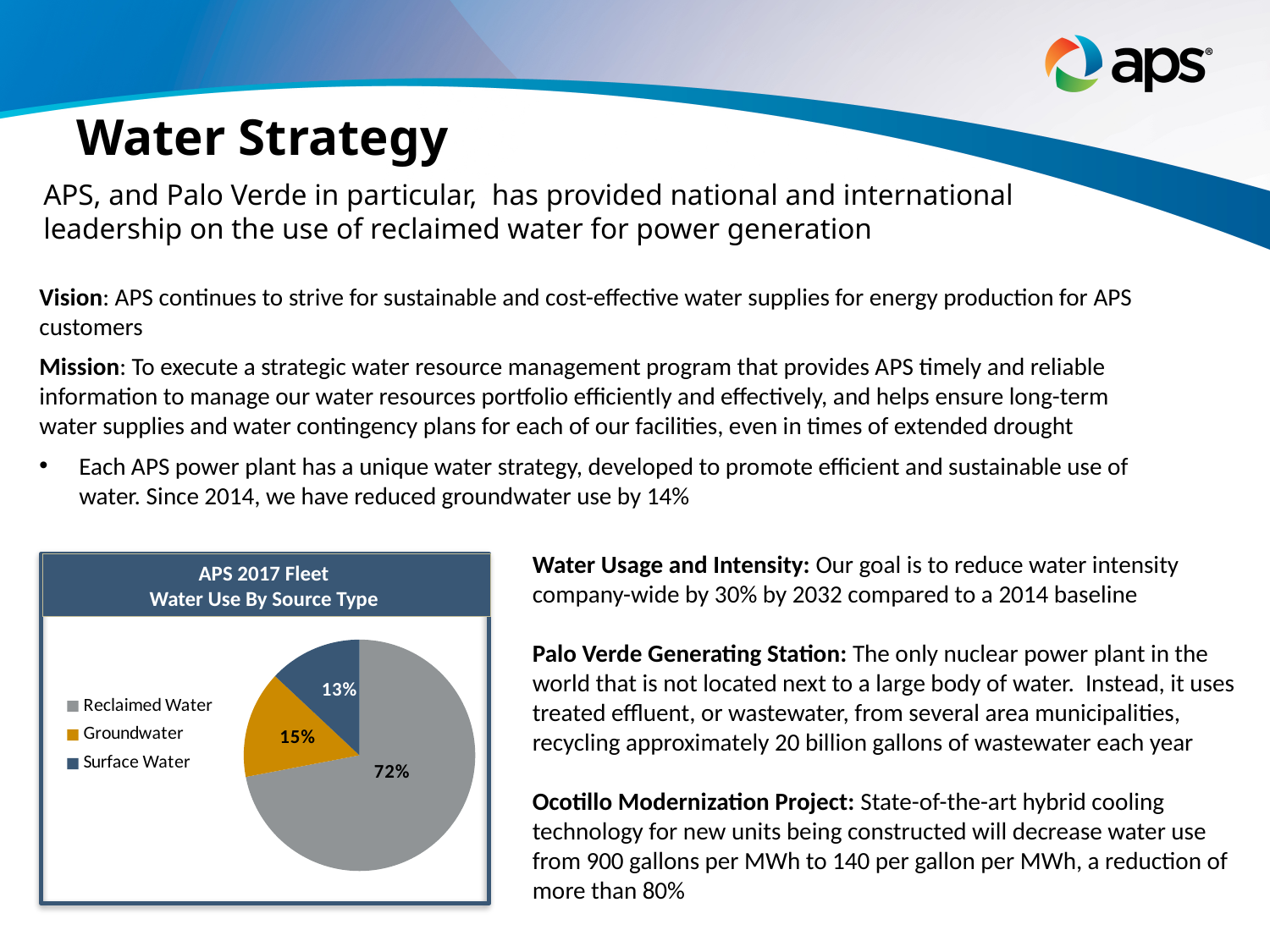
Which source type has the smallest share of water use? Surface Water Which source type has the largest share of water use? Reclaimed Water What share of water use comes from Reclaimed Water? 72% Which colour represents Groundwater in the pie chart? gold What is the title of the chart? APS 2017 Fleet Water Use By Source Type What share of water use comes from Surface Water? 13% What share of water use comes from Groundwater? 15% What is the difference in percentage points between Reclaimed Water and Groundwater? 57 What kind of chart is shown on the slide? pie chart What is the difference in percentage points between Groundwater and Surface Water? 2 How many source types are shown in the pie chart? 3 Which is larger, the share for Groundwater or the share for Surface Water? Groundwater